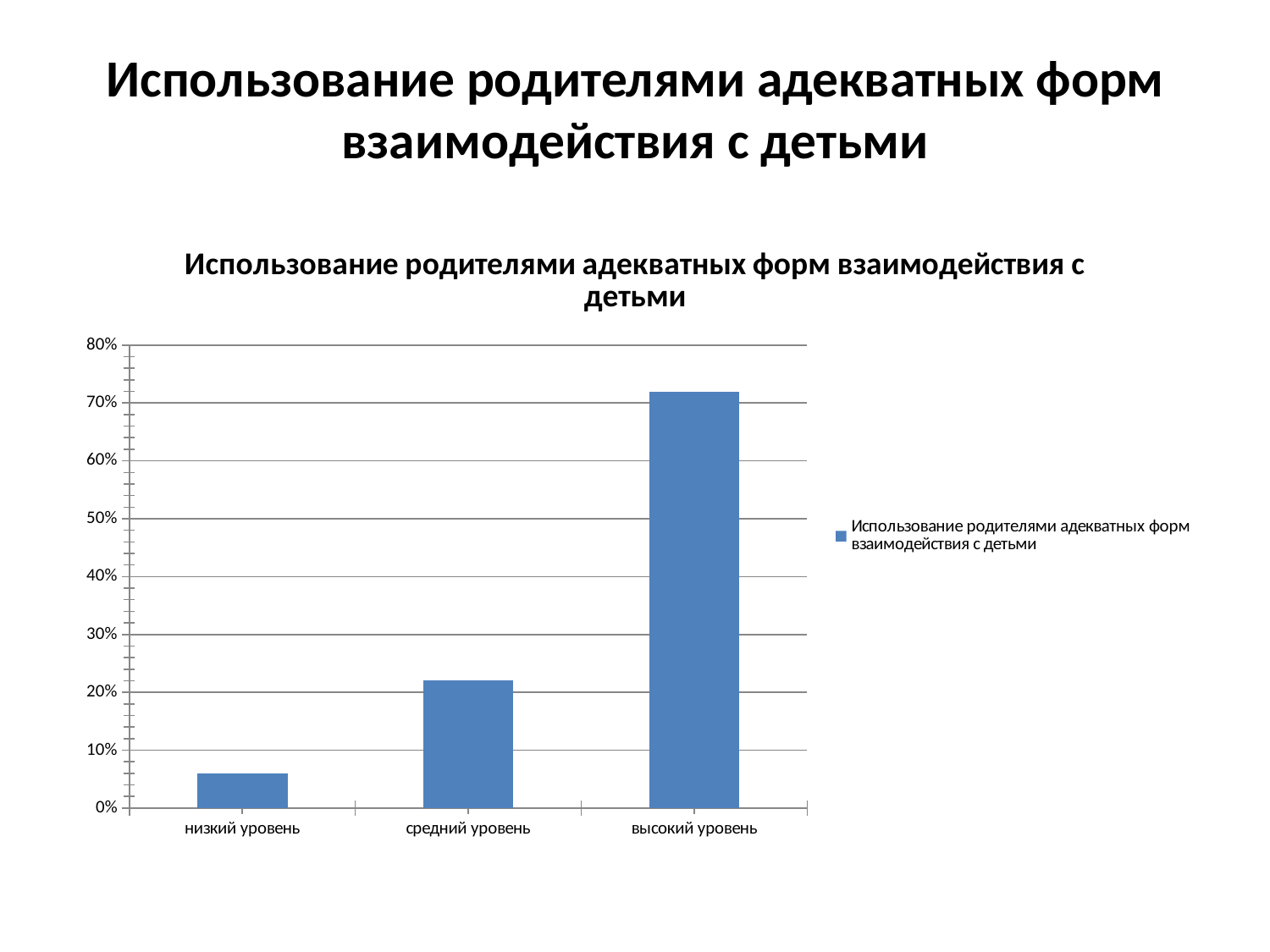
Which category has the lowest value in the chart? низкий уровень Is the value for средний уровень greater or less than 30%? less Is the value for высокий уровень greater or less than 70%? greater How many categories are shown on the x axis of the chart? 3 Which category has the highest value in the chart? высокий уровень Which is larger, the value for низкий уровень or the value for средний уровень? средний уровень Is the value for низкий уровень greater or less than 10%? less What is the title of the chart? Использование родителями адекватных форм взаимодействия с детьми What kind of chart is shown on the slide? bar chart Do the values rise or fall from left to right along the x axis? rise How many series does the chart legend list? 1 Which is larger, the value for средний уровень or the value for высокий уровень? высокий уровень